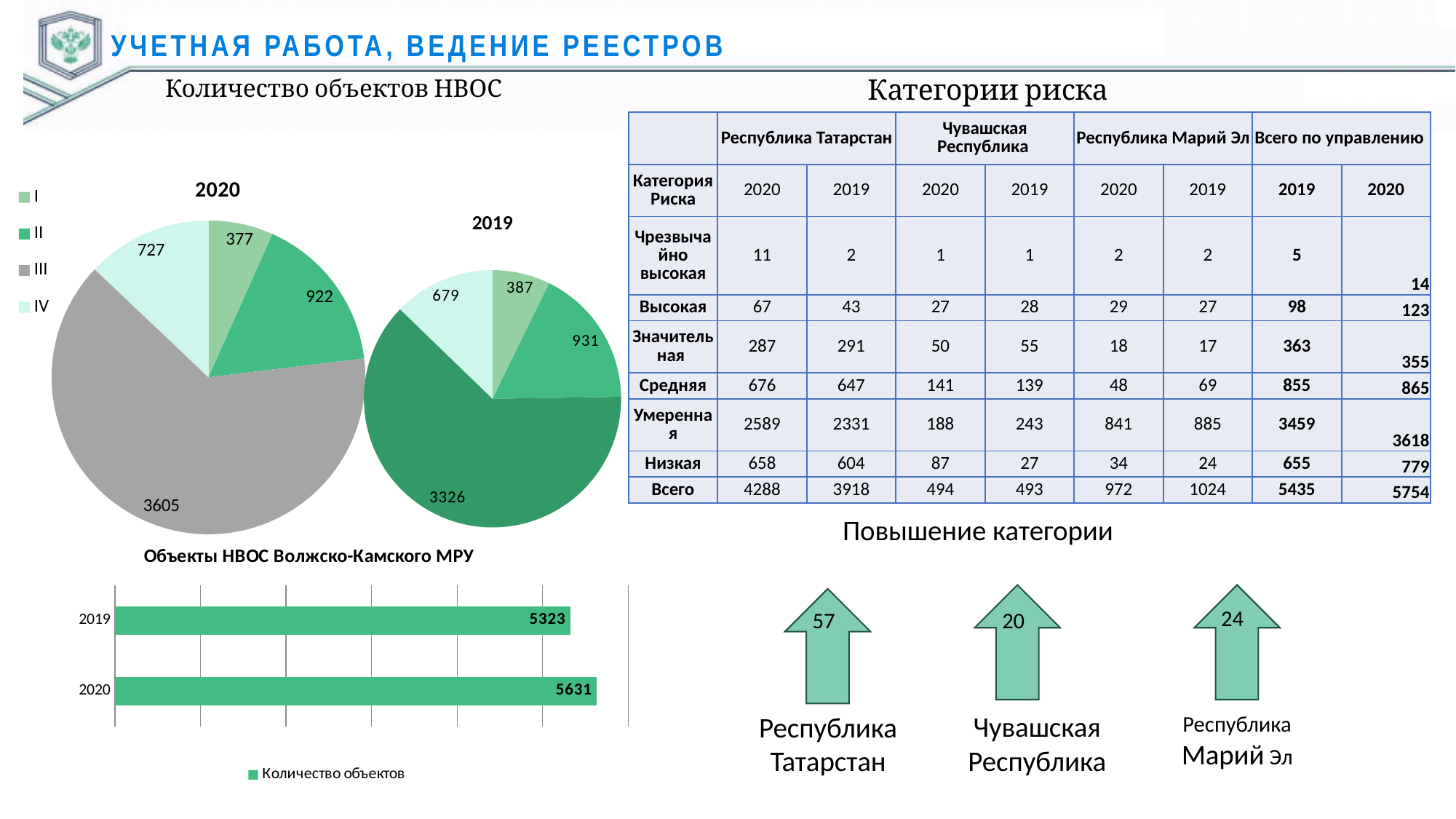
In the 2020 pie chart, what is the difference between the values for category II and category IV? 195 In the bar chart 'Объекты НВОС Волжско-Камского МРУ', what is the value for 2019? 5323 In the 2020 pie chart, which category has the largest slice? III In the bar chart 'Объекты НВОС Волжско-Камского МРУ', what is the value for 2020? 5631 In the 2020 pie chart, what is the value for category III? 3605 In the bar chart 'Объекты НВОС Волжско-Камского МРУ', what is the difference between the 2020 and 2019 values? 308 What kind of chart is the 2020 chart under 'Количество объектов НВОС'? pie chart In the 2019 pie chart, what is the value of the largest slice? 3326 How many series does the legend of the bar chart 'Объекты НВОС Волжско-Камского МРУ' list? 1 In the 2020 pie chart, what is the value for category I? 377 In the 2020 pie chart, which category has the smallest slice? I In the 2019 pie chart, which is larger: the slice labelled 387 or the slice labelled 679? 679